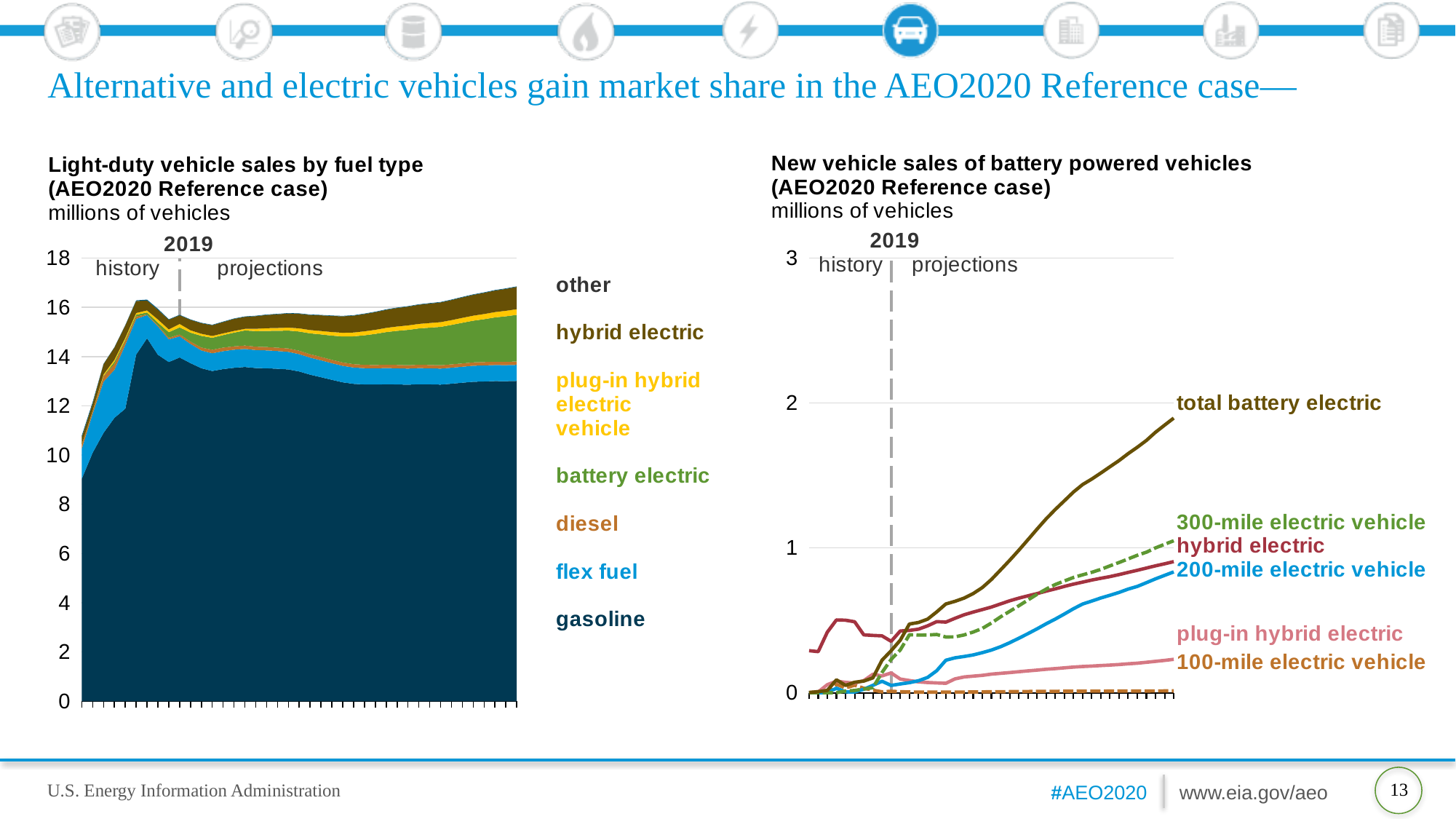
In the right chart, which series has the lowest value at the end of the projection period? 100-mile electric vehicle In the right chart, is the value for total battery electric at the end of the projection period greater or less than 2? less In the right chart, which series has the highest value at the end of the projection period? total battery electric What kind of chart is the right chart, 'New vehicle sales of battery powered vehicles'? line chart In the right chart, at the end of the projection period, which is larger: the 300-mile electric vehicle or the 200-mile electric vehicle? 300-mile electric vehicle In the right chart, does total battery electric rise or fall over the projection period? rise What kind of chart is the left chart, 'Light-duty vehicle sales by fuel type'? stacked area chart In the right chart, is the value for total battery electric at the end of the projection period greater or less than 1? greater How many fuel-type series does the legend of the left chart list? 7 In the left chart, which fuel type accounts for the largest share of light-duty vehicle sales? gasoline How many series are labelled on the right chart, 'New vehicle sales of battery powered vehicles'? 6 What unit is used on the y axis of the left chart, 'Light-duty vehicle sales by fuel type'? millions of vehicles